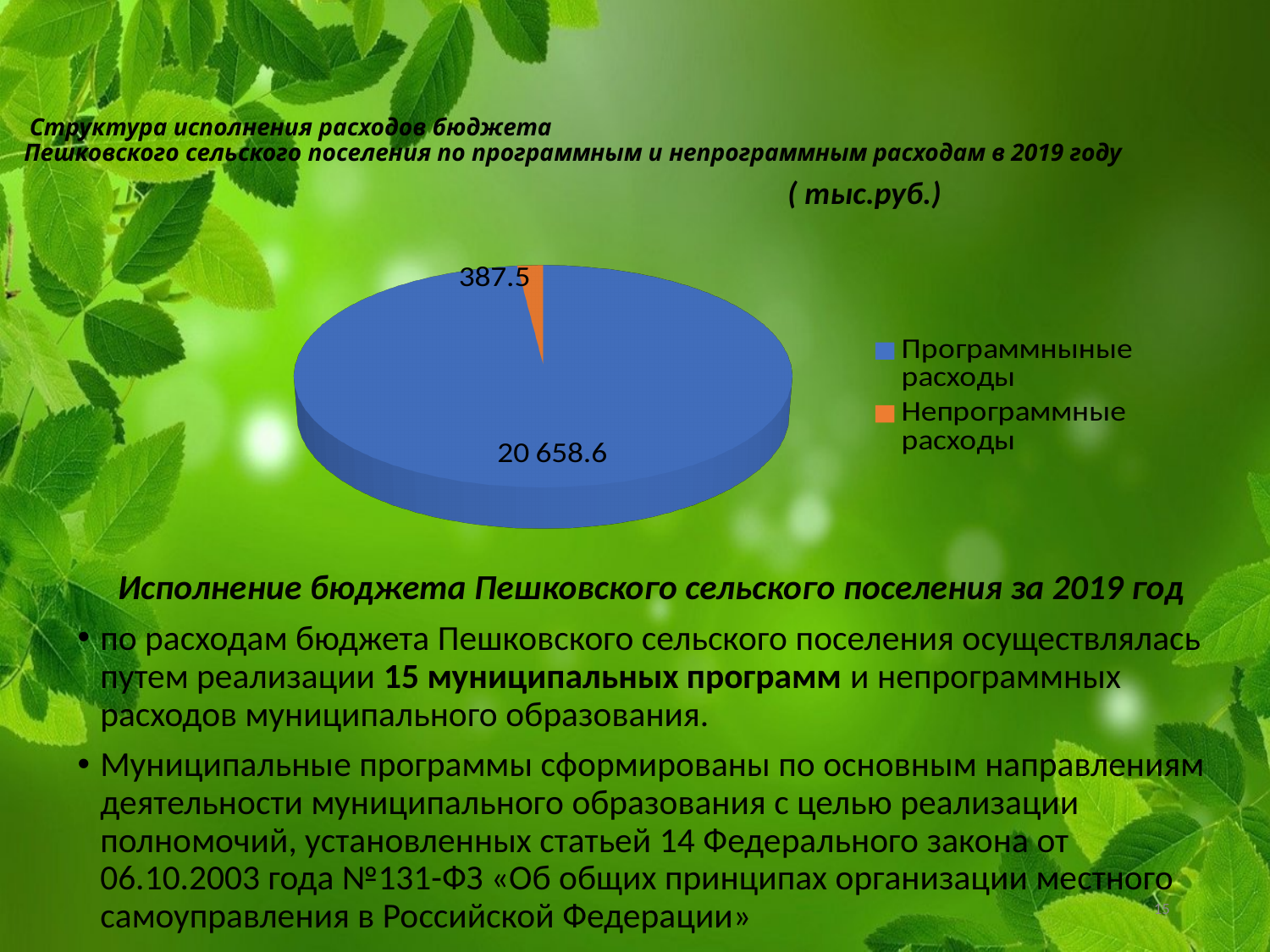
How many slices does the pie chart have? 2 Which is larger, Программныные расходы or Непрограммные расходы? Программныные расходы In what units are the values of the chart given, according to the title? тыс.руб. What is the total of the two slices in the pie chart? 21 046.1 What is the value for Непрограммные расходы in the pie chart? 387.5 What kind of chart is shown on the slide? Pie chart What is the value for Программныные расходы in the pie chart? 20 658.6 What is the difference between Программныные расходы and Непрограммные расходы? 20 271.1 How many entries does the legend list? 2 What colour represents Непрограммные расходы in the pie chart? Orange Which category has the largest slice in the pie chart? Программныные расходы Which category has the smallest slice in the pie chart? Непрограммные расходы